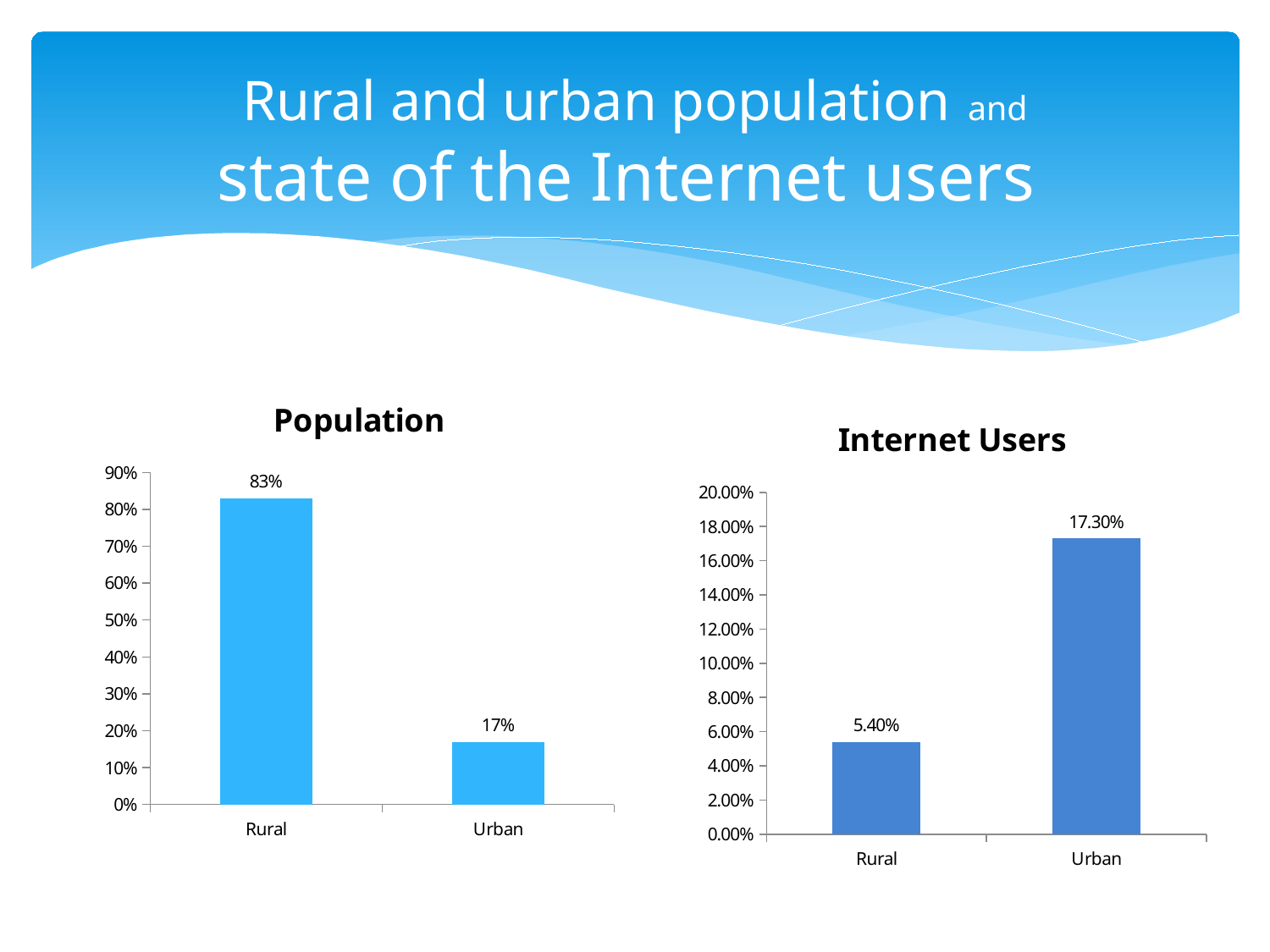
How many categories are shown in the Population chart? 2 In the Population chart, what is the value for Rural? 83% What is the title of the chart on the left side of the slide? Population In the Internet Users chart, what is the value for Rural? 5.40% What kind of chart is the Internet Users chart? Bar chart In the Internet Users chart, which category has the lowest value? Rural In the Internet Users chart, what is the difference between the Urban and Rural values? 11.90% In the Internet Users chart, which is larger, Rural or Urban? Urban In the Population chart, what is the difference between the Rural and Urban values? 66% In the Internet Users chart, what is the value for Urban? 17.30% In the Population chart, what is the value for Urban? 17% In the Population chart, which category has the highest value? Rural